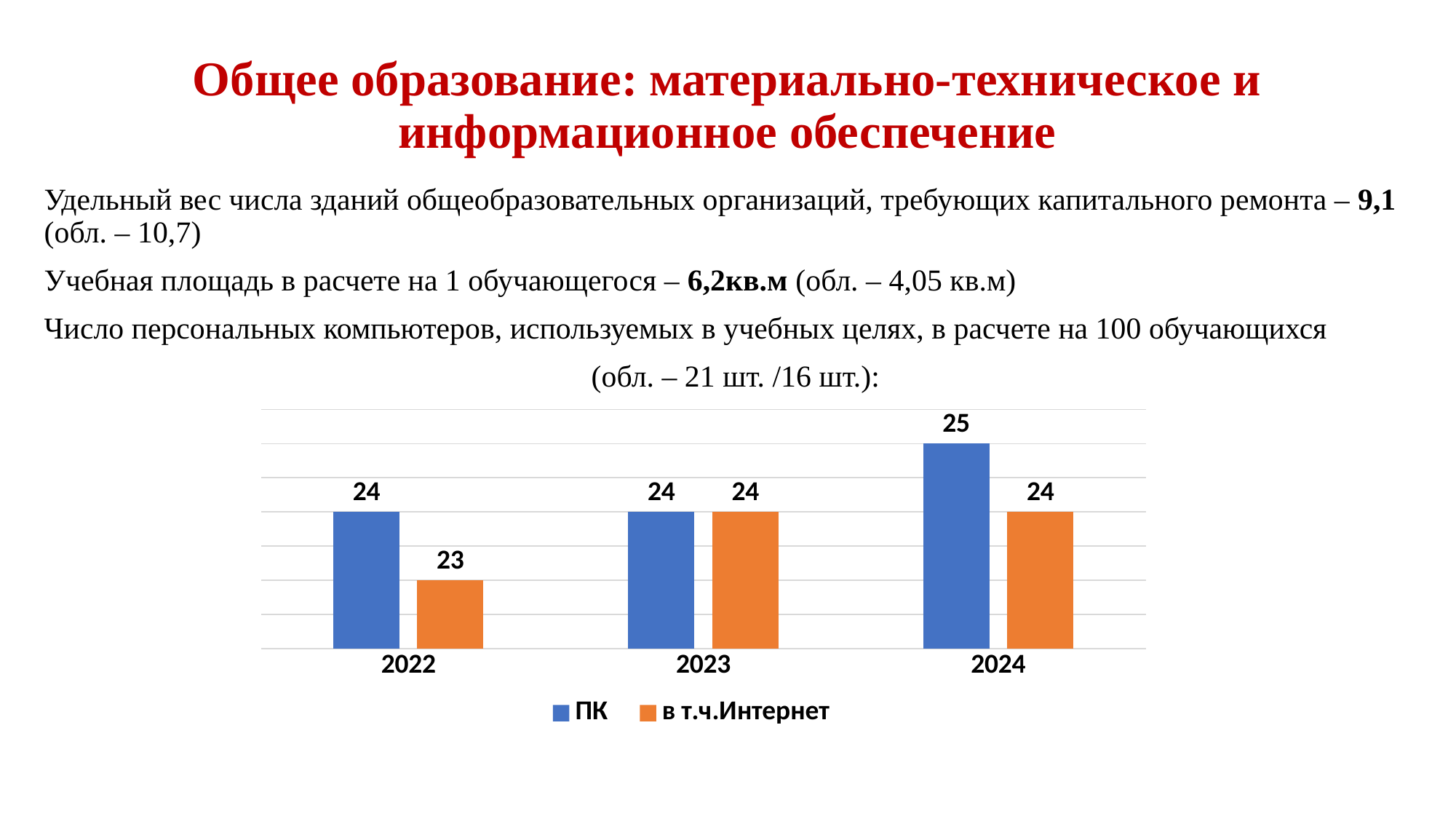
Does the в т.ч.Интернет value rise or fall from 2022 to 2023? rise What is the value for ПК in 2024? 25 In which year is the в т.ч.Интернет value lowest? 2022 What is the value for в т.ч.Интернет in 2023? 24 Which is larger in 2022: the ПК value or the в т.ч.Интернет value? ПК What kind of chart is shown on the slide? bar chart What is the difference between the ПК and в т.ч.Интернет values in 2024? 1 What is the value for ПК in 2022? 24 In which year is the ПК value highest? 2024 How many series does the chart legend list? 2 How many years are shown on the x axis of the chart? 3 What is the value for в т.ч.Интернет in 2022? 23